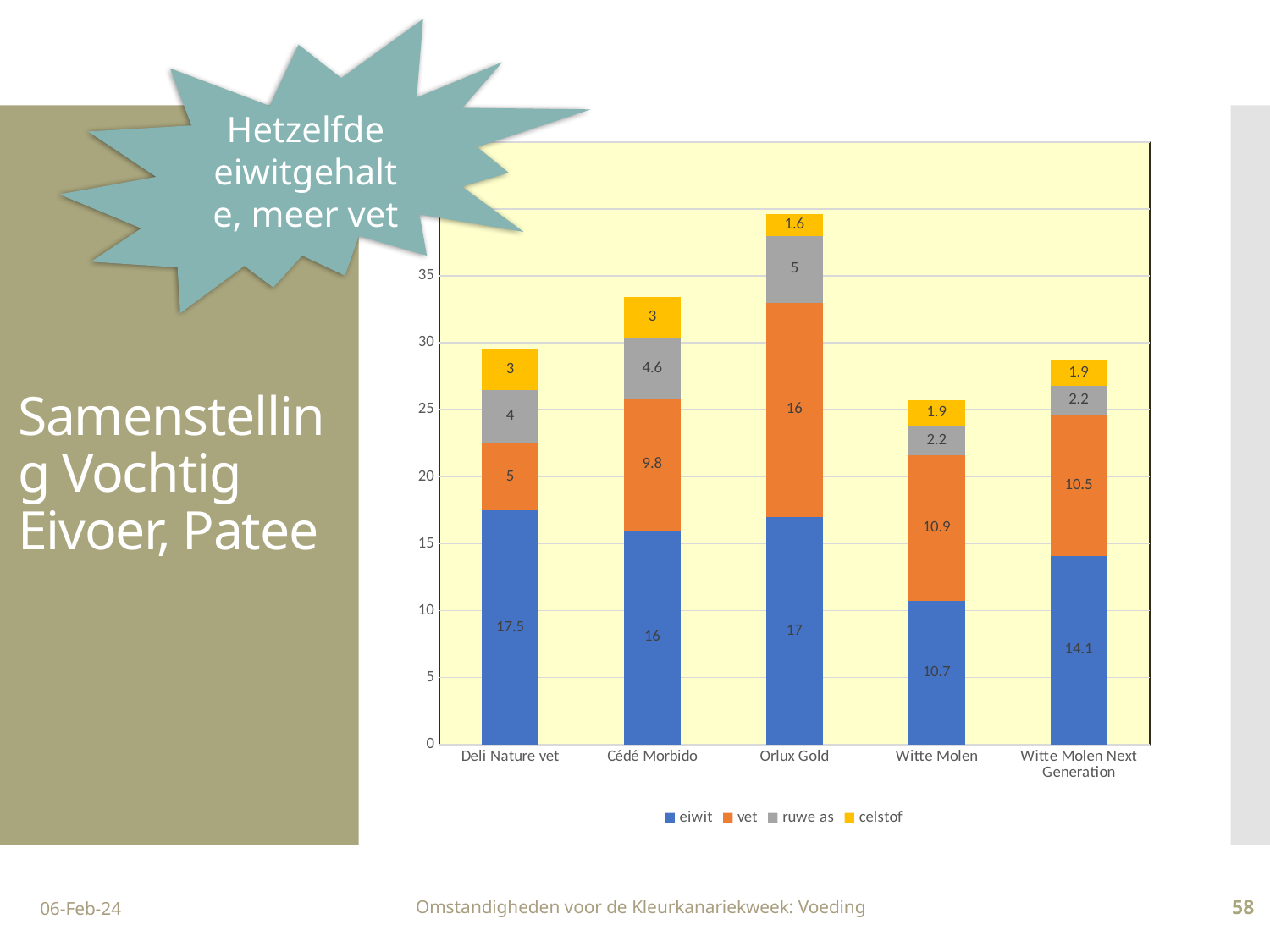
What kind of chart is shown on the slide? Stacked bar chart How many categories are shown on the x axis? 5 What is the total of the stacked bar for Orlux Gold? 39.6 Which is larger, the eiwit value for Cédé Morbido or the eiwit value for Witte Molen Next Generation? Cédé Morbido Which category has the highest vet value? Orlux Gold What is the ruwe as value for Cédé Morbido? 4.6 What is the celstof value for Witte Molen Next Generation? 1.9 What is the difference between the vet values of Orlux Gold and Deli Nature vet? 11 What is the vet value for Orlux Gold? 16 What is the eiwit value for Deli Nature vet? 17.5 How many series does the legend list? 4 Which category has the lowest eiwit value? Witte Molen